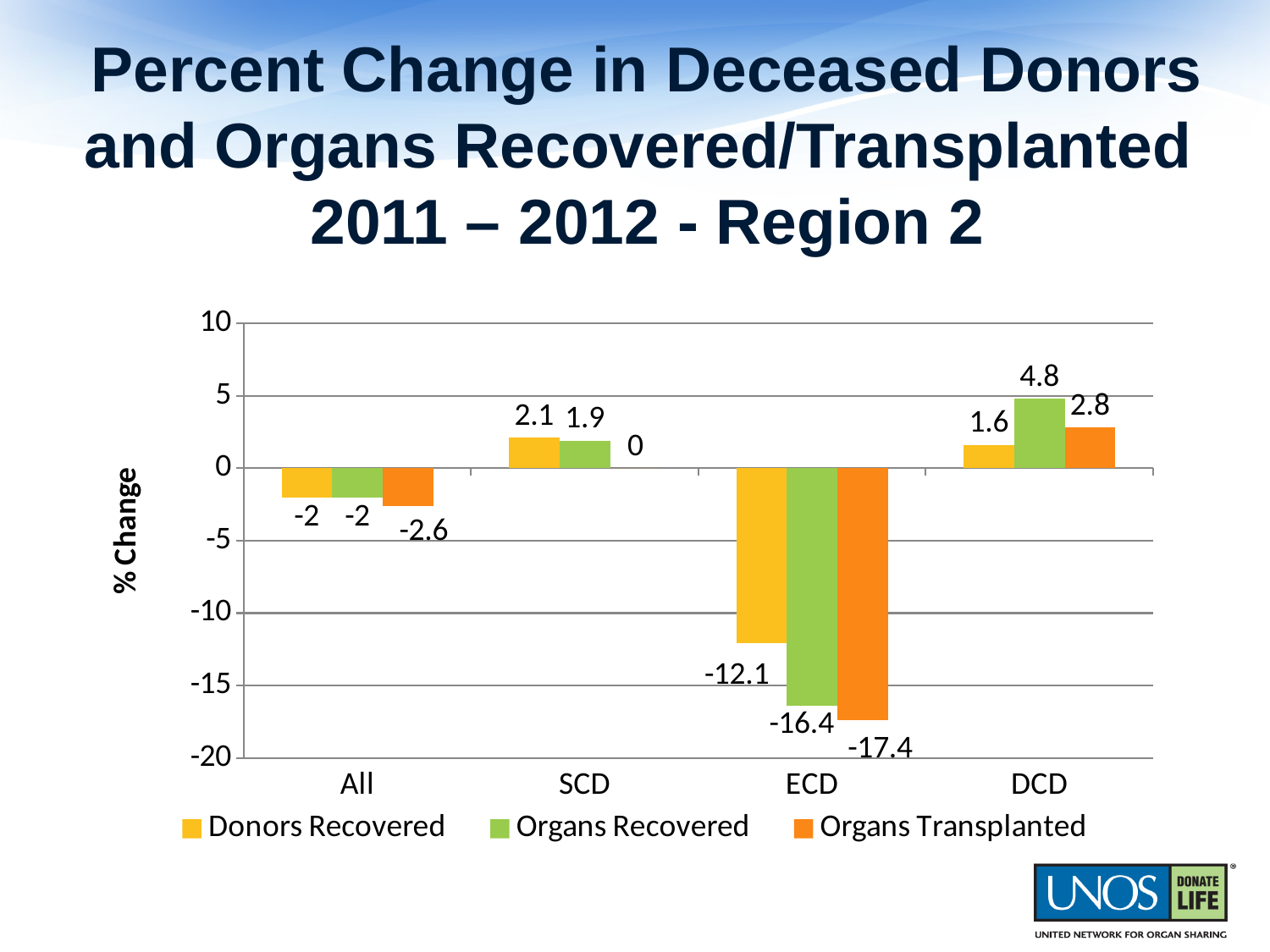
What is the value for Organs Transplanted in the ECD category? -17.4 What is the difference between the Organs Recovered value and the Donors Recovered value in the ECD category? 4.3 What is the value for Organs Recovered in the DCD category? 4.8 What is the value for Donors Recovered in the SCD category? 2.1 Which is larger in the DCD category: Donors Recovered or Organs Transplanted? Organs Transplanted Which category has the highest value for Organs Recovered? DCD How many categories are shown on the x axis? 4 Is the value for Organs Recovered in the ECD category greater or less than -15? less What kind of chart is shown on the slide? bar chart Which category has the lowest value for Donors Recovered? ECD What is the value for Organs Transplanted in the All category? -2.6 How many series does the legend list? 3